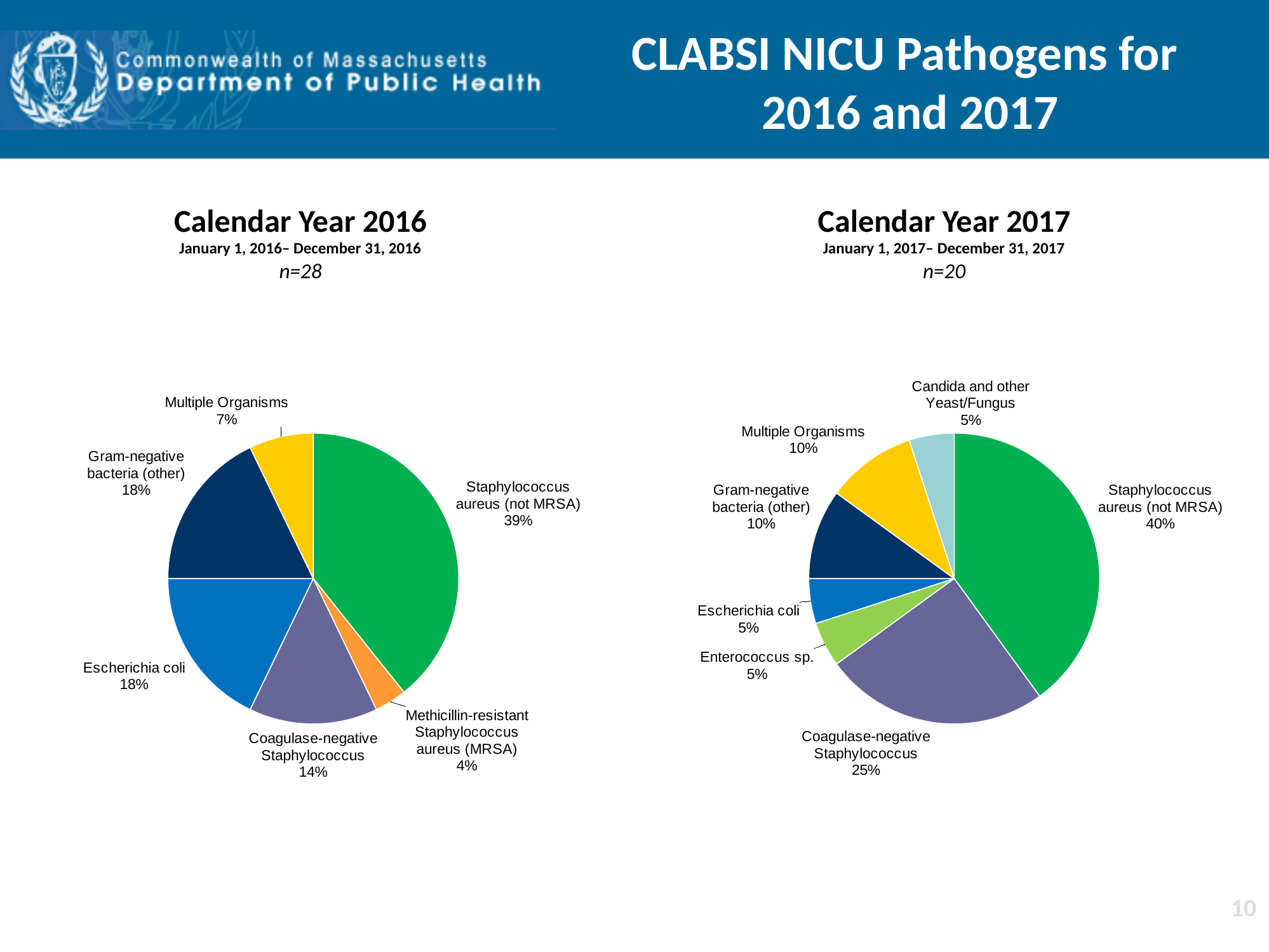
In the Calendar Year 2017 pie chart, what share is Candida and other Yeast/Fungus? 5% In the Calendar Year 2016 pie chart, how many slices are there? 6 In the Calendar Year 2016 pie chart, what is the difference between the Gram-negative bacteria (other) share and the Multiple Organisms share? 11% What is the n value shown for the Calendar Year 2017 chart? n=20 What kind of chart is the Calendar Year 2016 chart? Pie chart In the Calendar Year 2017 pie chart, which pathogen has the largest slice? Staphylococcus aureus (not MRSA) In the Calendar Year 2016 pie chart, what share is Staphylococcus aureus (not MRSA)? 39% In the Calendar Year 2017 pie chart, what share is Coagulase-negative Staphylococcus? 25% In the Calendar Year 2017 pie chart, which is larger: Multiple Organisms or Escherichia coli? Multiple Organisms In the Calendar Year 2016 pie chart, which pathogen has the smallest slice? Methicillin-resistant Staphylococcus aureus (MRSA) In the Calendar Year 2017 pie chart, how many slices are there? 7